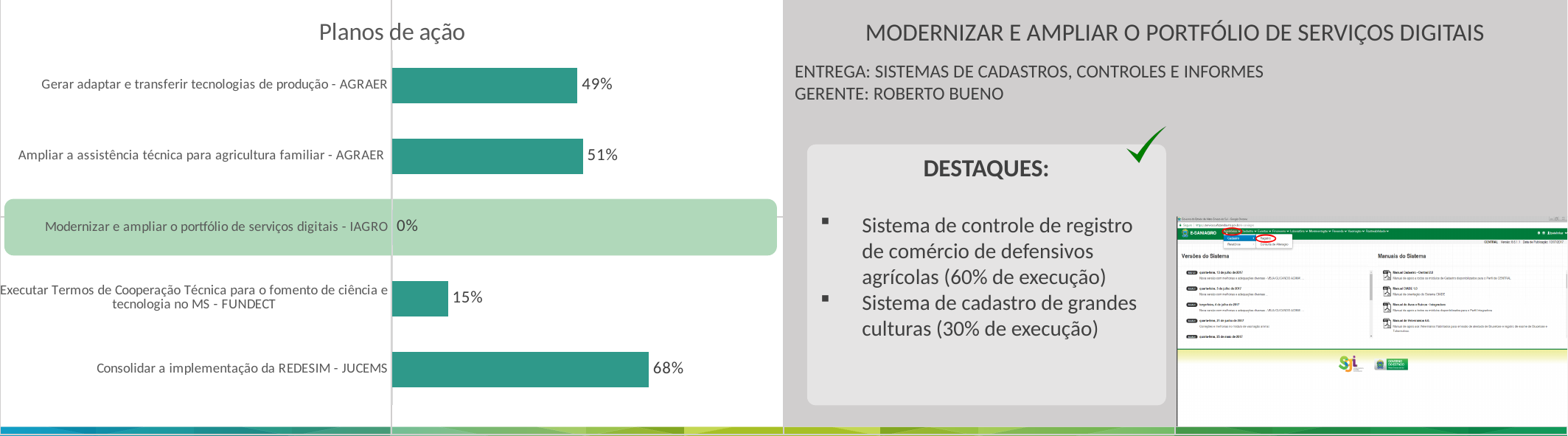
Which action plan's row is highlighted with a light green band? Modernizar e ampliar o portfólio de serviços digitais - IAGRO How many action plans are shown in the chart? 5 What is the difference between the values for 'Consolidar a implementação da REDESIM - JUCEMS' and 'Gerar adaptar e transferir tecnologias de produção - AGRAER'? 19% What is the value for 'Executar Termos de Cooperação Técnica para o fomento de ciência e tecnologia no MS - FUNDECT'? 15% What is the value for 'Modernizar e ampliar o portfólio de serviços digitais - IAGRO'? 0% Which action plan has the lowest value? Modernizar e ampliar o portfólio de serviços digitais - IAGRO What is the value for 'Consolidar a implementação da REDESIM - JUCEMS'? 68% What is the value for 'Ampliar a assistência técnica para agricultura familiar - AGRAER'? 51% What is the title of the chart? Planos de ação What kind of chart is shown on the slide? Bar chart Which action plan has the highest value? Consolidar a implementação da REDESIM - JUCEMS Which is larger: the value for 'Ampliar a assistência técnica para agricultura familiar - AGRAER' or for 'Gerar adaptar e transferir tecnologias de produção - AGRAER'? Ampliar a assistência técnica para agricultura familiar - AGRAER